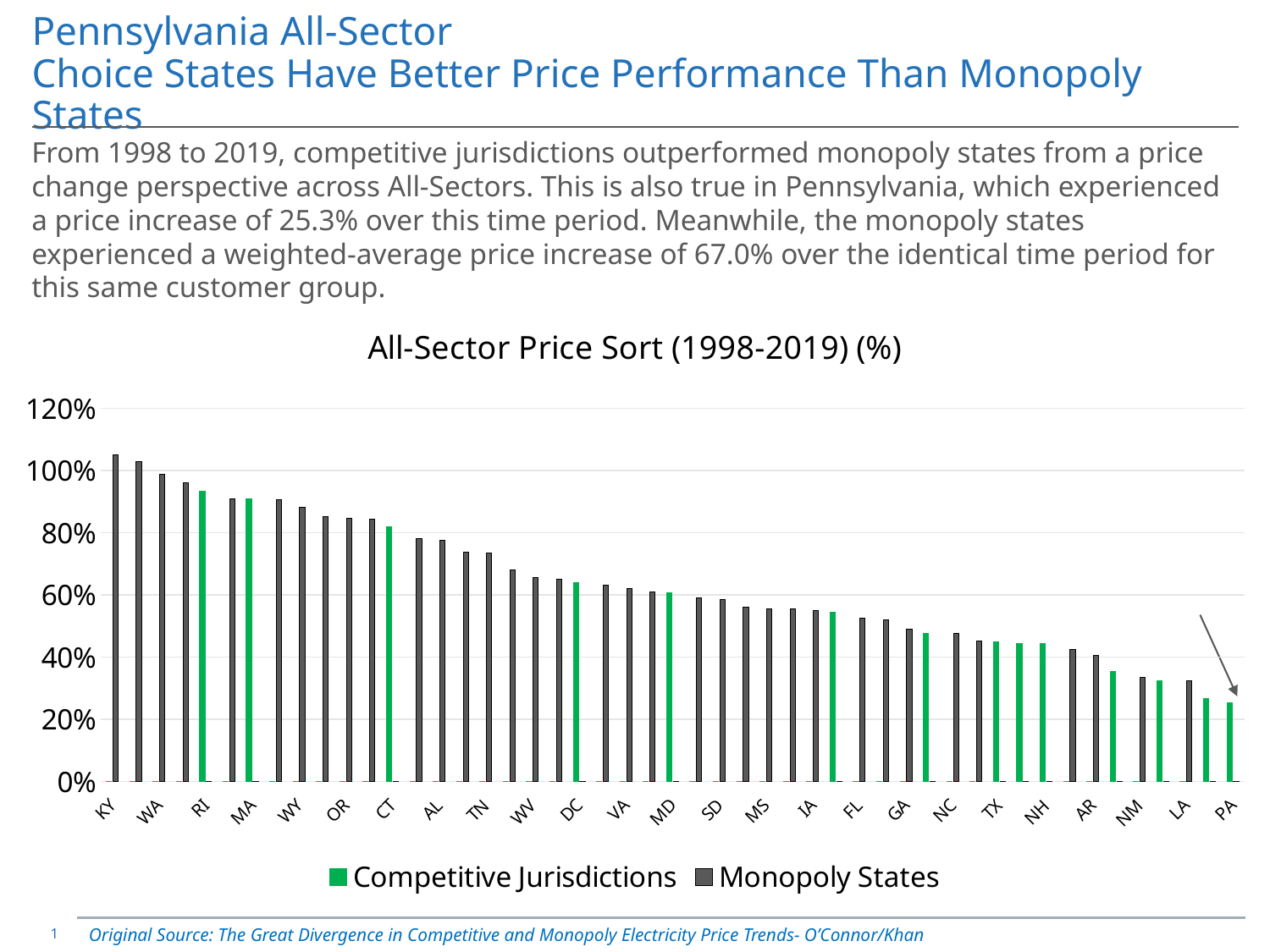
What is the title of the chart? All-Sector Price Sort (1998-2019) (%) Is the value for NH greater or less than 60%? less Which legend series is shown in green? Competitive Jurisdictions How many series does the chart legend list? 2 Which state has the lowest value in the chart? PA Which has the larger value, WA or LA? WA Do the values rise or fall moving from left to right along the x axis? fall Is the value for KY greater or less than 100%? greater Is the value for CT greater or less than 60%? greater What kind of chart is shown on the slide? bar chart Which state has the highest value in the chart? KY